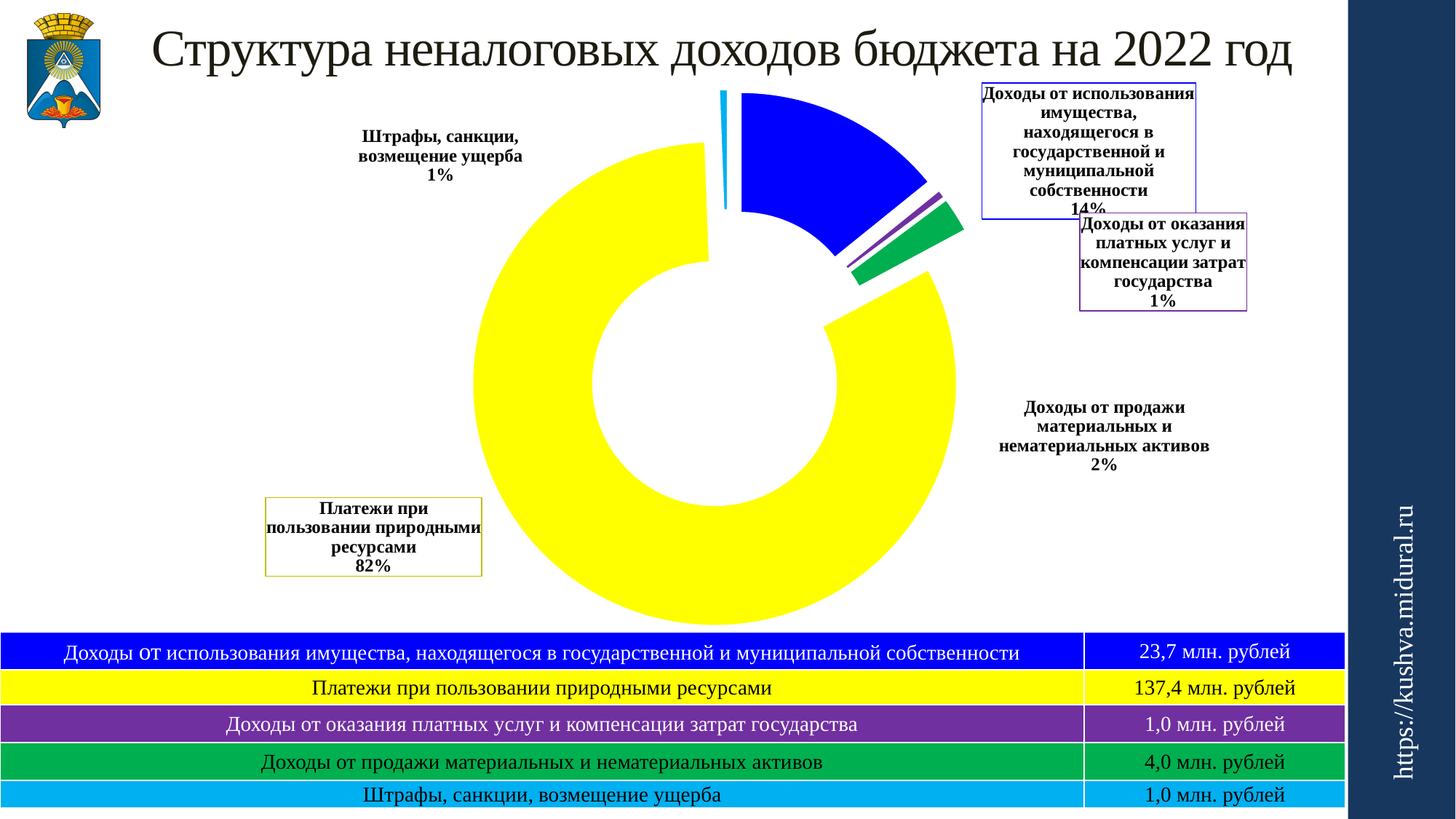
What share of the pie does «Платежи при пользовании природными ресурсами» have? 82% What share of the pie does «Доходы от использования имущества, находящегося в государственной и муниципальной собственности» have? 14% Which category has the largest share of the pie? Платежи при пользовании природными ресурсами By how many percentage points does the share of «Платежи при пользовании природными ресурсами» exceed that of «Доходы от использования имущества, находящегося в государственной и муниципальной собственности»? 68 Which is larger: the share of «Доходы от продажи материальных и нематериальных активов» or the share of «Штрафы, санкции, возмещение ущерба»? Доходы от продажи материальных и нематериальных активов How many categories are shown in the pie chart? 5 What share of the pie does «Доходы от оказания платных услуг и компенсации затрат государства» have? 1% What kind of chart is shown on the slide? Doughnut chart What is the title of the chart? Структура неналоговых доходов бюджета на 2022 год What colour is the slice for «Платежи при пользовании природными ресурсами»? Yellow